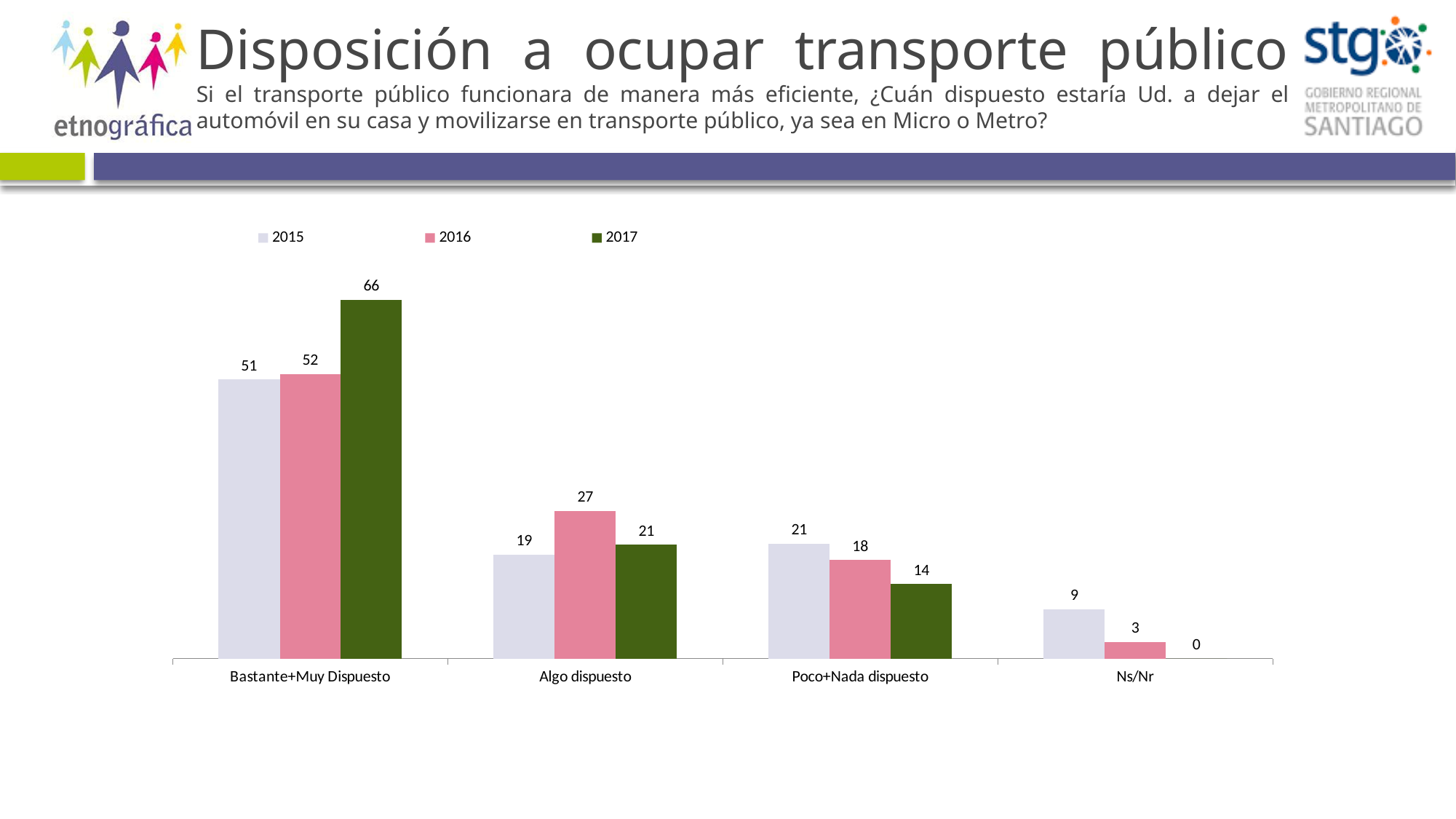
Which category has the highest value for 2017? Bastante+Muy Dispuesto How many series does the legend list? 3 What is the difference between the 2017 and 2015 values in the Bastante+Muy Dispuesto category? 15 How many categories are shown on the x axis? 4 Which series is shown in dark green in the legend? 2017 What kind of chart is shown on the slide? Bar chart What is the value for 2017 in the Bastante+Muy Dispuesto category? 66 What is the value for 2017 in the Poco+Nada dispuesto category? 14 Which category has the lowest value for 2016? Ns/Nr What is the value for 2016 in the Algo dispuesto category? 27 Which is larger in the Algo dispuesto category, the 2016 value or the 2017 value? 2016 What is the value for 2015 in the Ns/Nr category? 9